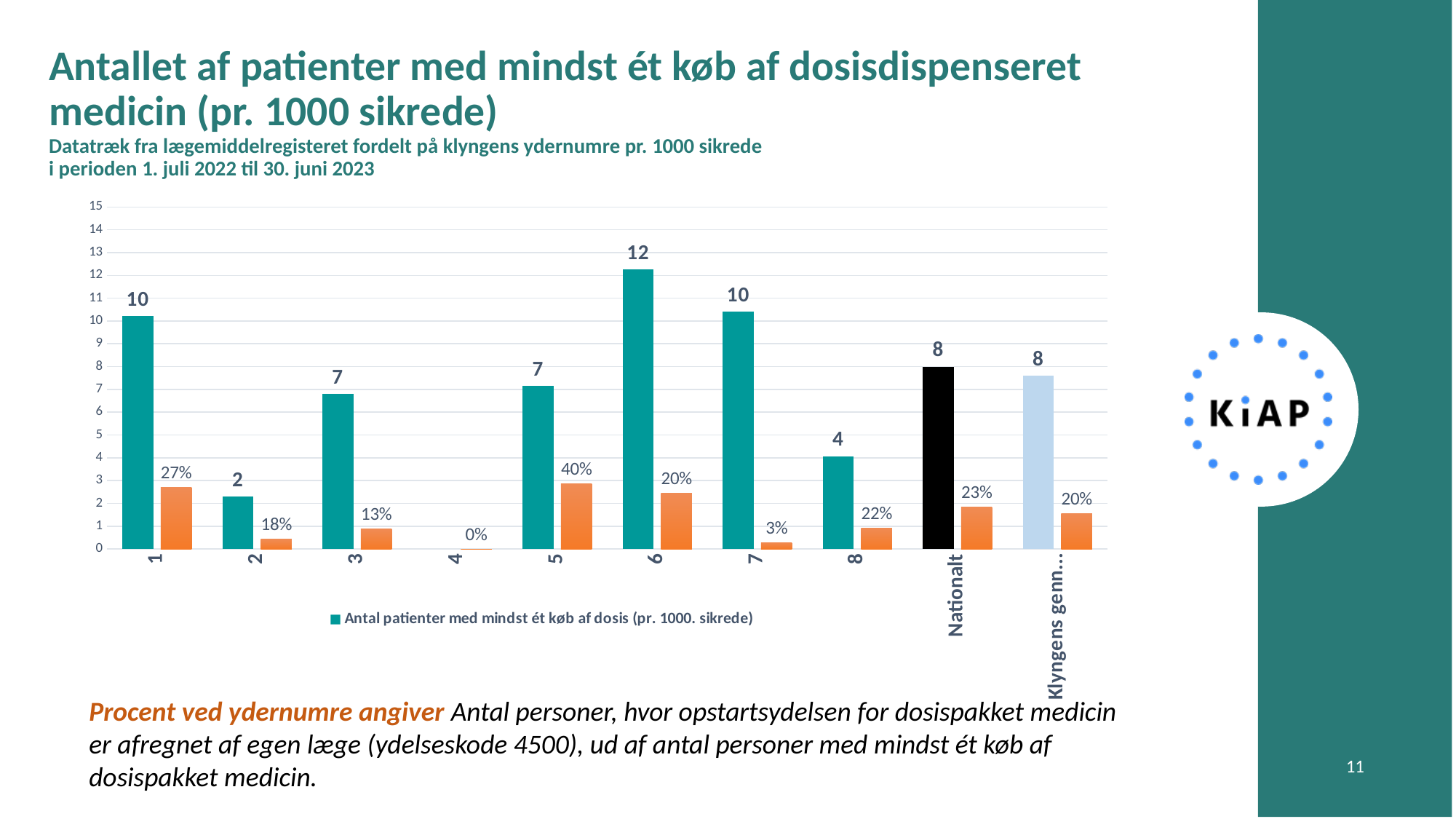
What kind of chart is shown on the slide? bar chart What is the labelled value for Nationalt? 8 How many categories are shown on the x axis? 10 Which ydernummer has the highest number of patients with at least one purchase of dose-dispensed medicine? 6 What percentage is shown for ydernummer 5? 40% Which has a higher labelled value, ydernummer 3 or ydernummer 8? 3 What is the difference between the labelled values for ydernummer 6 and ydernummer 1? 2 What percentage is shown for ydernummer 7? 3% What is the labelled value of the teal bar for ydernummer 6? 12 Which category has the lowest percentage label? 4 Is the value for ydernummer 2 greater or less than 5? less Which category has the highest percentage label? 5